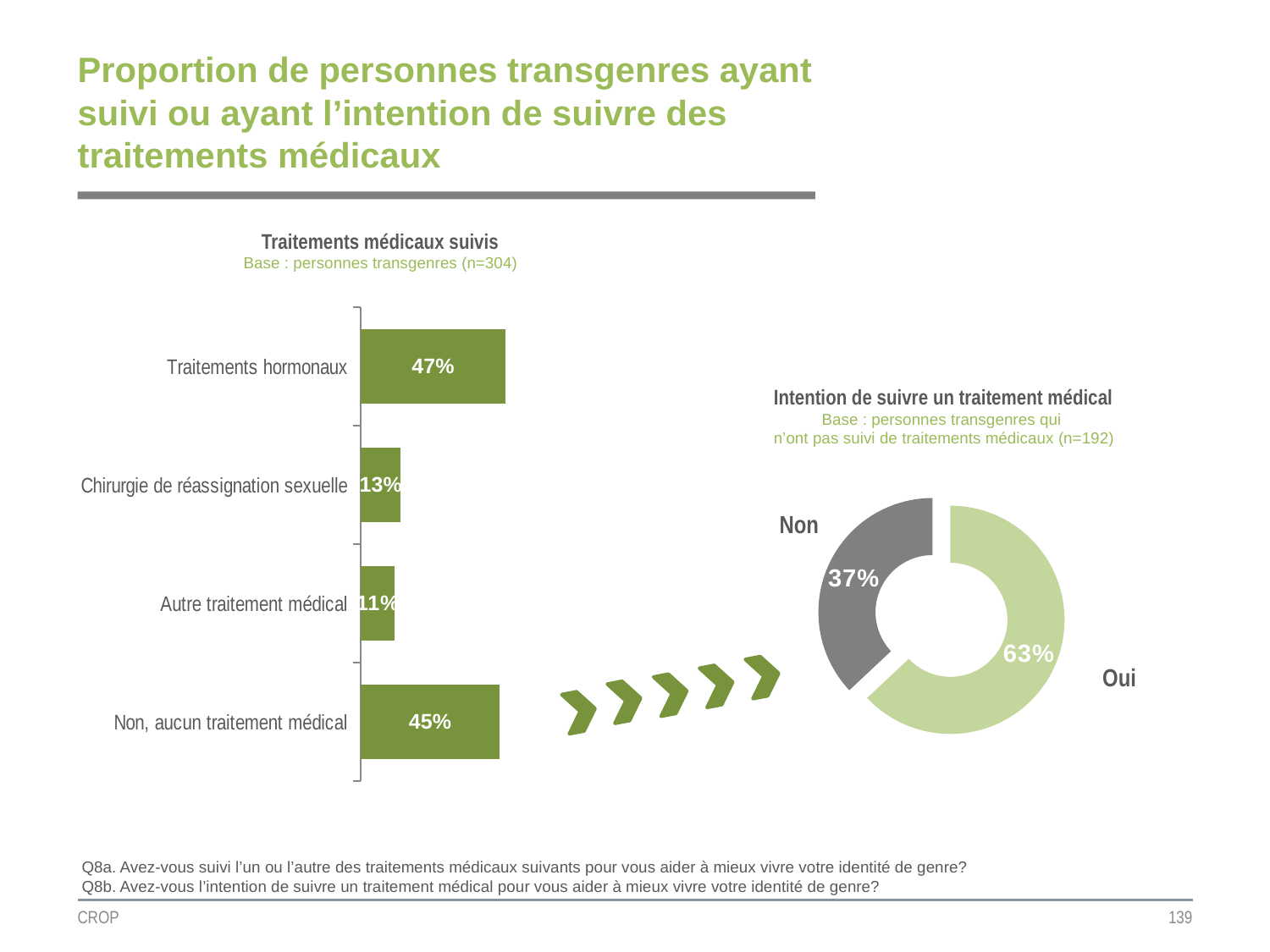
In the 'Traitements médicaux suivis' chart, what is the difference between 'Traitements hormonaux' and 'Non, aucun traitement médical'? 2% What kind of chart is the 'Traitements médicaux suivis' chart? Bar chart In the 'Traitements médicaux suivis' chart, what is the value for 'Chirurgie de réassignation sexuelle'? 13% In the 'Traitements médicaux suivis' chart, which category has the lowest value? Autre traitement médical How many categories are shown in the 'Traitements médicaux suivis' chart? 4 In the 'Intention de suivre un traitement médical' chart, what is the value for 'Non'? 37% In the 'Traitements médicaux suivis' chart, which is larger: 'Chirurgie de réassignation sexuelle' or 'Autre traitement médical'? Chirurgie de réassignation sexuelle In the 'Traitements médicaux suivis' chart, which category has the highest value? Traitements hormonaux In the 'Intention de suivre un traitement médical' chart, what share is 'Oui'? 63% In the 'Traitements médicaux suivis' chart, what is the value for 'Autre traitement médical'? 11% In the 'Traitements médicaux suivis' chart, what is the value for 'Traitements hormonaux'? 47% What kind of chart is the 'Intention de suivre un traitement médical' chart? Doughnut chart